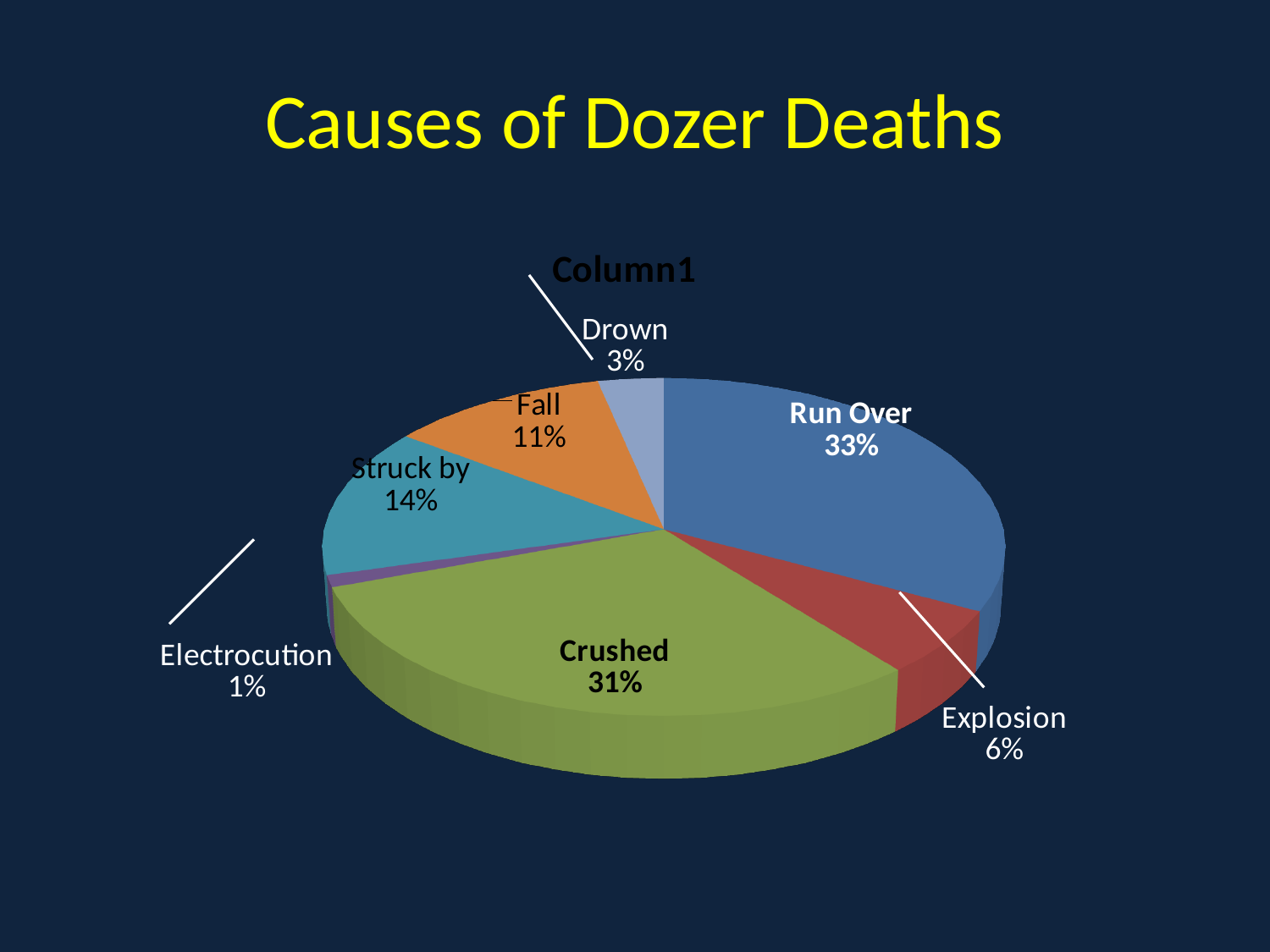
Which is larger, the share for Explosion or the share for Drown? Explosion What percentage is shown for Fall? 11% Which cause of dozer deaths has the smallest share? Electrocution Which cause of dozer deaths has the largest share? Run Over How many causes of dozer deaths are shown in the pie chart? 7 What share of the pie does Struck by represent? 14% What is the difference in percentage points between Struck by and Fall? 3% What percentage of dozer deaths is caused by Crushed? 31% What share is shown for Electrocution? 1% What type of chart is shown on the slide? Pie chart What percentage of dozer deaths is due to Explosion? 6% What share of dozer deaths is attributed to Run Over? 33%